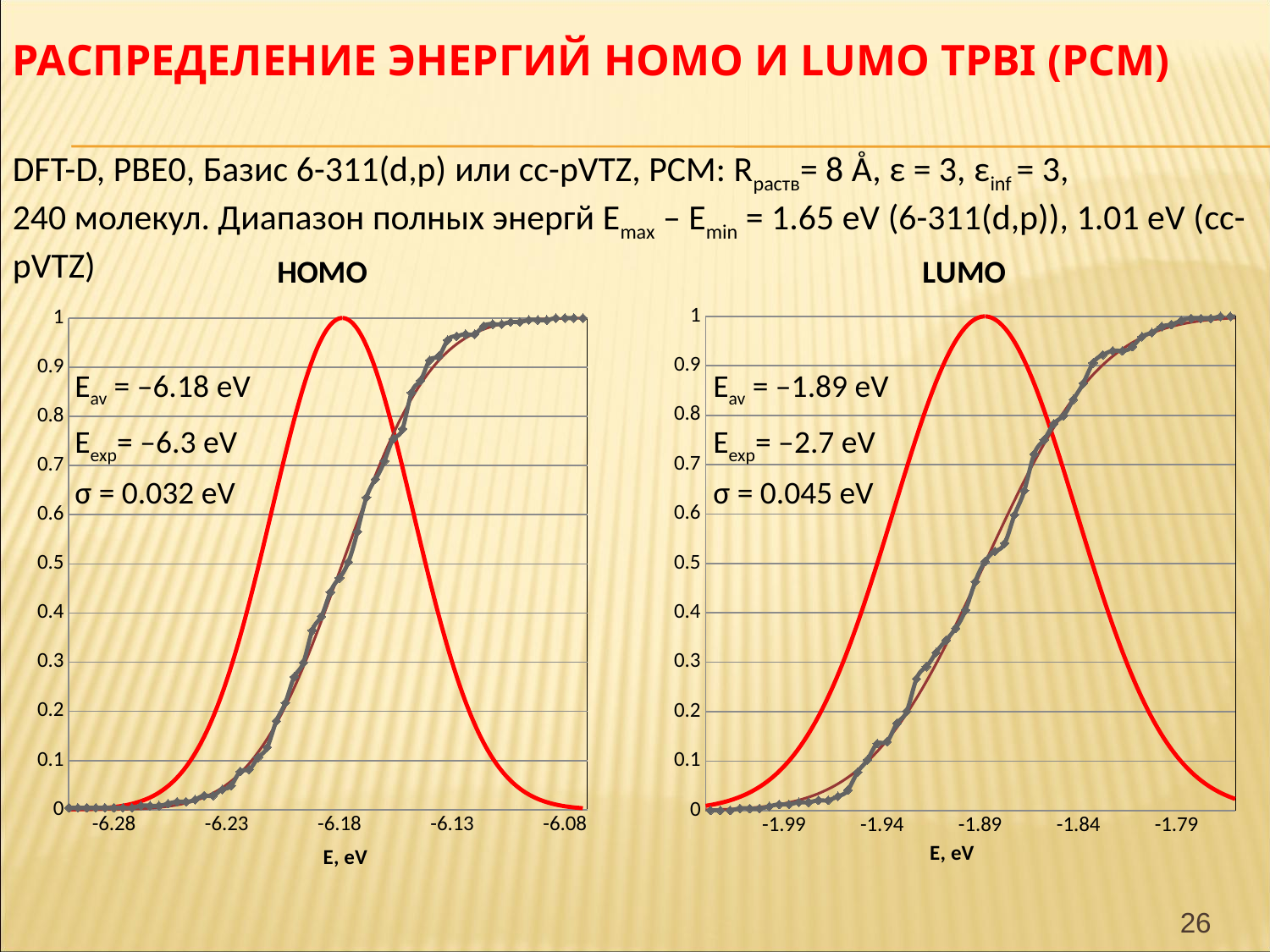
On the HOMO chart, does the grey marked curve rise or fall as E increases along the x axis? rise What is the x-axis title of the LUMO chart? E, eV On the HOMO chart, what value of σ is printed? 0.032 eV On the HOMO chart, what value of E_av is printed? –6.18 eV On the LUMO chart, is the value of the grey marked curve at E = -1.94 greater or less than 0.3? less On the LUMO chart, what value of E_av is printed? –1.89 eV On the LUMO chart, what value of σ is printed? 0.045 eV On the LUMO chart, at which x-axis tick does the red curve reach its peak? -1.89 What kind of chart is the HOMO chart? line chart On the HOMO chart, is the value of the grey marked curve at E = -6.13 greater or less than 0.8? greater On the HOMO chart, at which x-axis tick does the red curve reach its peak? -6.18 On the LUMO chart, what value of E_exp is printed? –2.7 eV